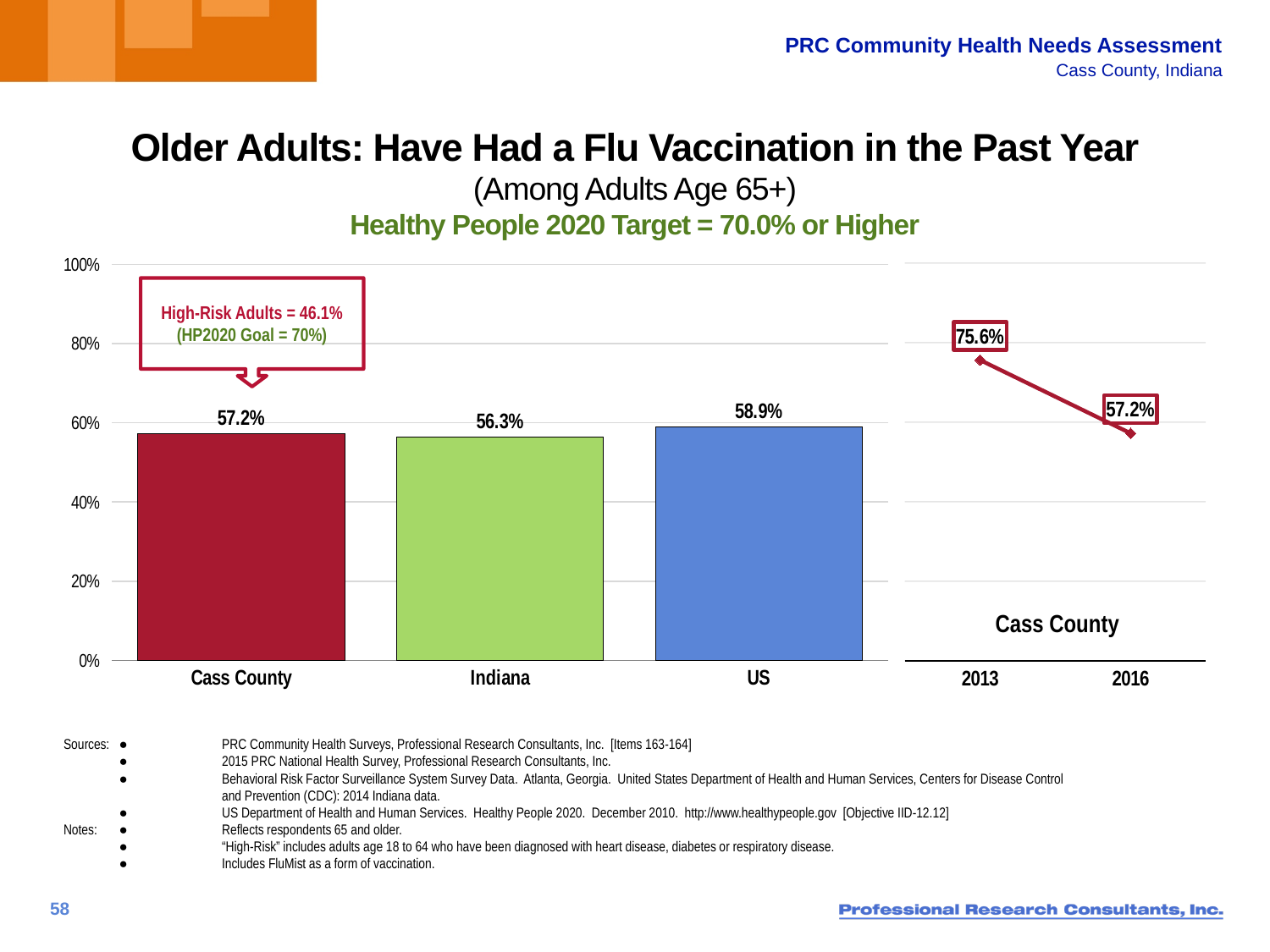
In the bar chart on the left, what is the value for Indiana? 56.3% In the bar chart on the left, what is the difference between the US value and the Indiana value? 2.6 percentage points What kind of chart is the chart on the left? Bar chart In the bar chart on the left, which category has the lowest value? Indiana In the trend chart on the right, did the Cass County value rise or fall from 2013 to 2016? Fall In the trend chart on the right, what is the Cass County value for 2013? 75.6% In the bar chart on the left, how many categories are shown? 3 In the bar chart on the left, what is the value for the US? 58.9% In the bar chart on the left, which category has the highest value? US In the bar chart on the left, what is the value for Cass County? 57.2% In the trend chart on the right, what is the difference between the 2013 and 2016 values for Cass County? 18.4 percentage points In the trend chart on the right, what is the Cass County value for 2016? 57.2%